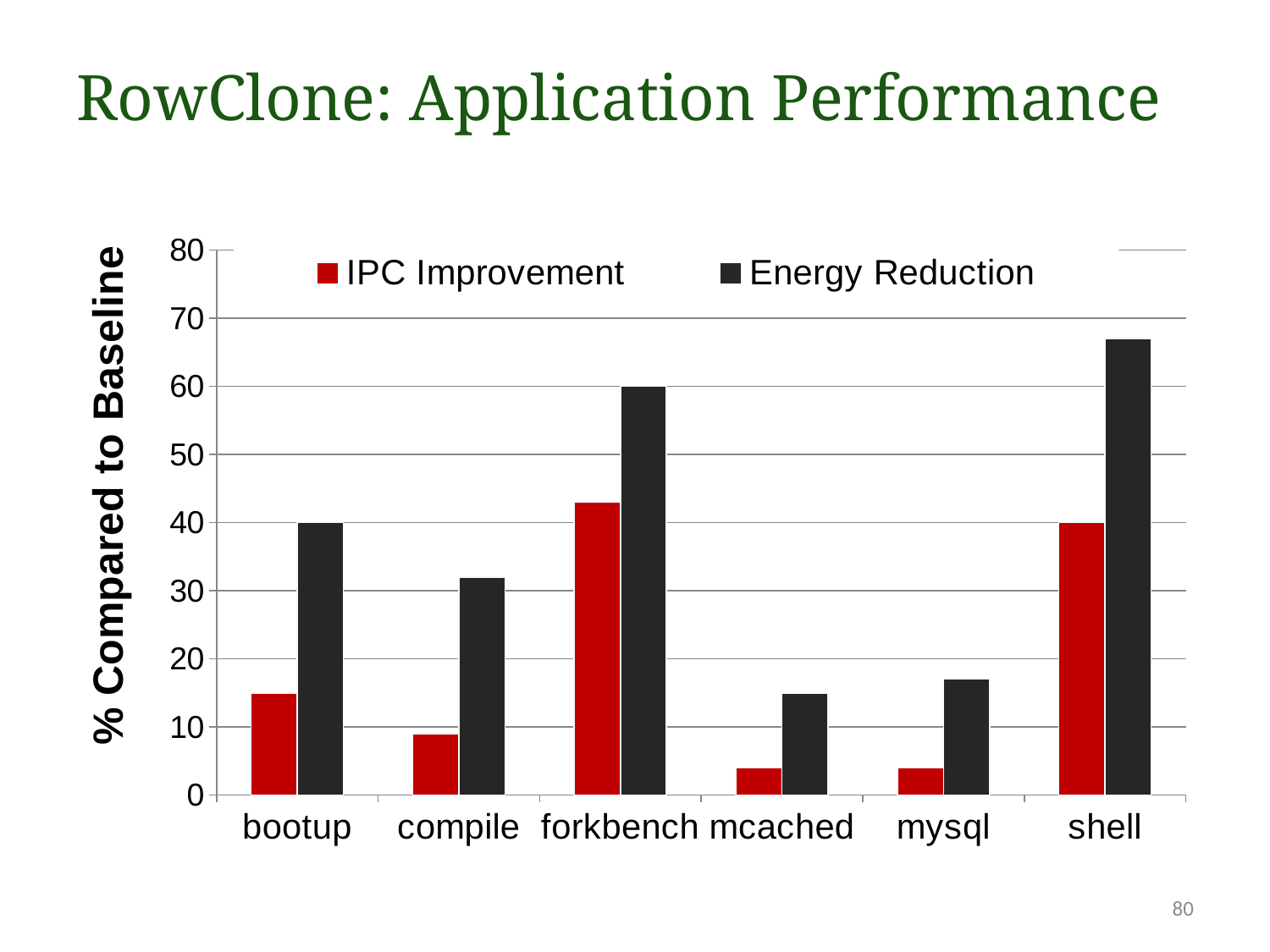
Is the Energy Reduction for compile greater or less than 30? greater What is the Energy Reduction value for forkbench? 60 Which application has the highest Energy Reduction? shell How many applications are shown on the x axis? 6 How many series does the legend list? 2 Is the IPC Improvement for compile greater or less than 10? less Which application has the highest IPC Improvement? forkbench What is the IPC Improvement value for shell? 40 What is the label on the y axis? % Compared to Baseline What is the Energy Reduction value for bootup? 40 Which is larger, the Energy Reduction for bootup or the Energy Reduction for compile? bootup What kind of chart is shown on the slide? bar chart